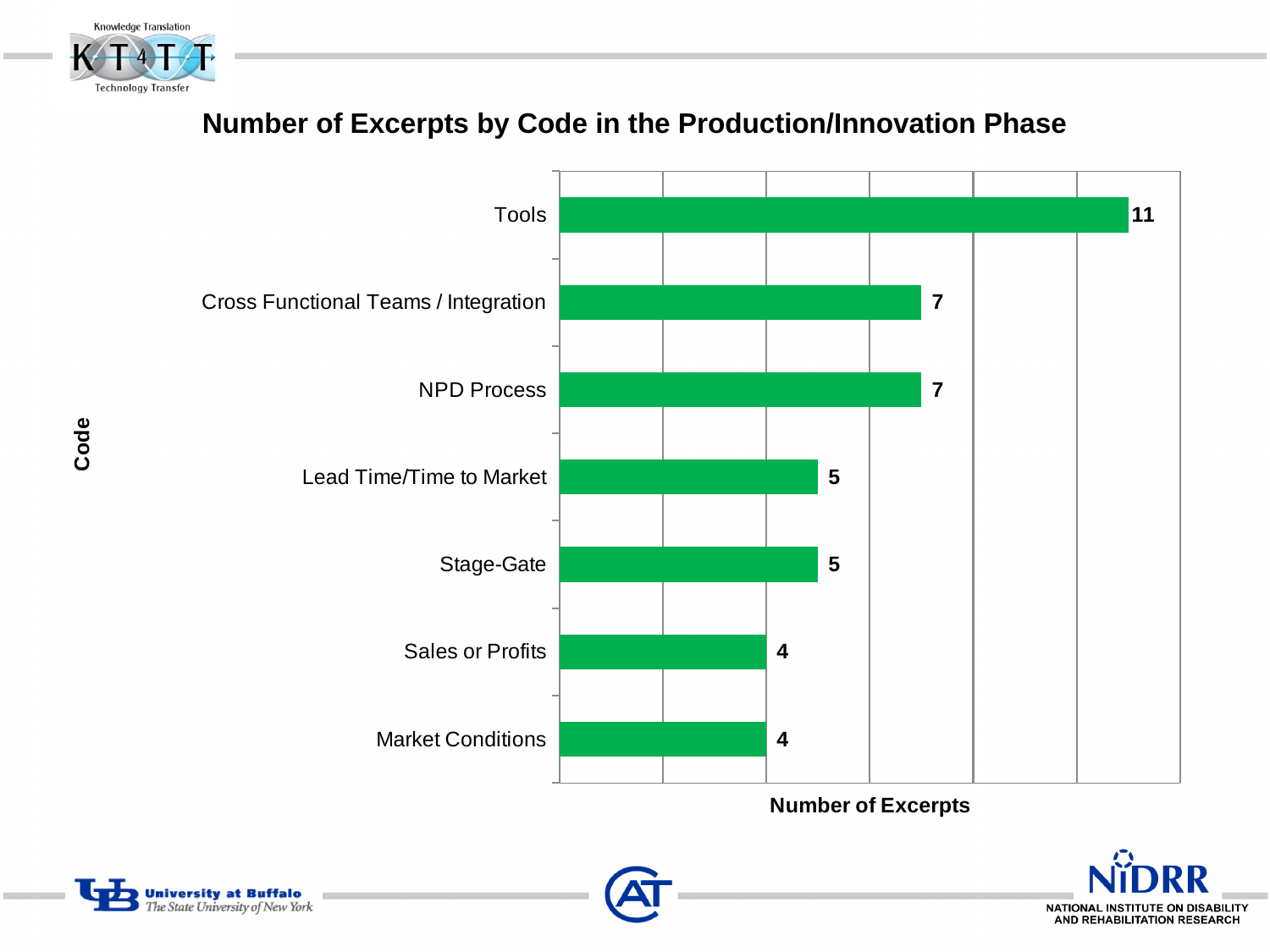
Which has more excerpts, Cross Functional Teams / Integration or Stage-Gate? Cross Functional Teams / Integration What is the difference in number of excerpts between Tools and NPD Process? 4 Which code has the highest number of excerpts? Tools What is the number of excerpts for Cross Functional Teams / Integration? 7 How many codes are shown in the chart? 7 What is the number of excerpts for Tools? 11 What is the difference in number of excerpts between Stage-Gate and Market Conditions? 1 What is the title of the chart? Number of Excerpts by Code in the Production/Innovation Phase What kind of chart is shown on the slide? Bar chart What is the label of the horizontal axis? Number of Excerpts What is the number of excerpts for Lead Time/Time to Market? 5 What is the number of excerpts for Sales or Profits? 4